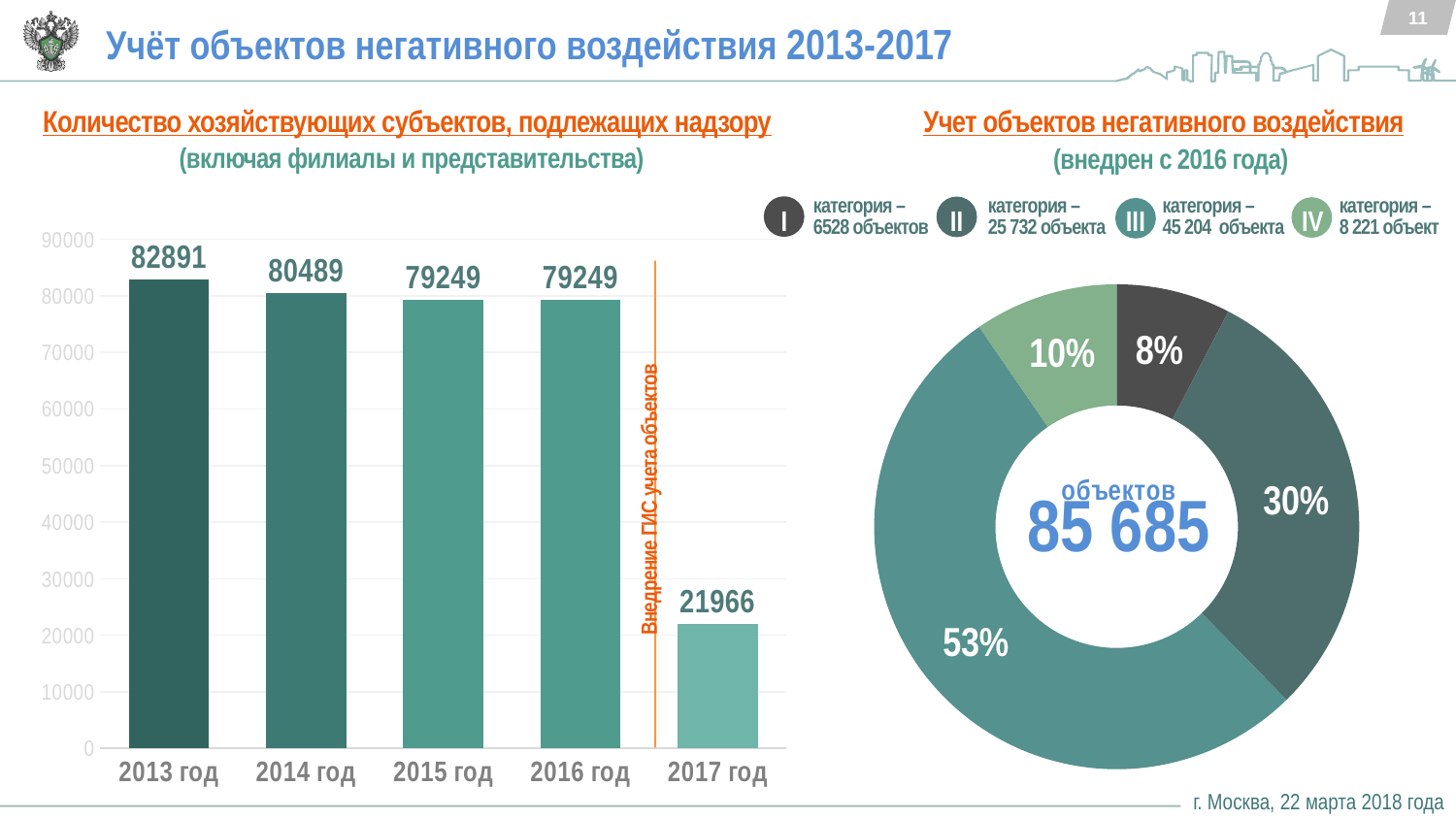
On the donut chart on the right, what is the largest slice's share? 53% On the bar chart on the left, which year has the highest value? 2013 год On the bar chart on the left, do the values rise or fall from 2013 год to 2017 год? fall On the donut chart on the right, what total number of объектов is shown in the centre? 85 685 On the right-hand chart, how many objects are listed for III категория in the legend? 45 204 объекта On the bar chart on the left, how many years are shown on the x axis? 5 On the bar chart on the left, which is larger, the value for 2014 год or the value for 2015 год? 2014 год On the bar chart on the left, what is the value for 2013 год? 82891 On the bar chart on the left, what is the value for 2017 год? 21966 On the bar chart on the left, what is the difference between the values for 2013 год and 2014 год? 2402 On the bar chart on the left, which year has the lowest value? 2017 год What kind of chart is shown on the left side of the slide? bar chart